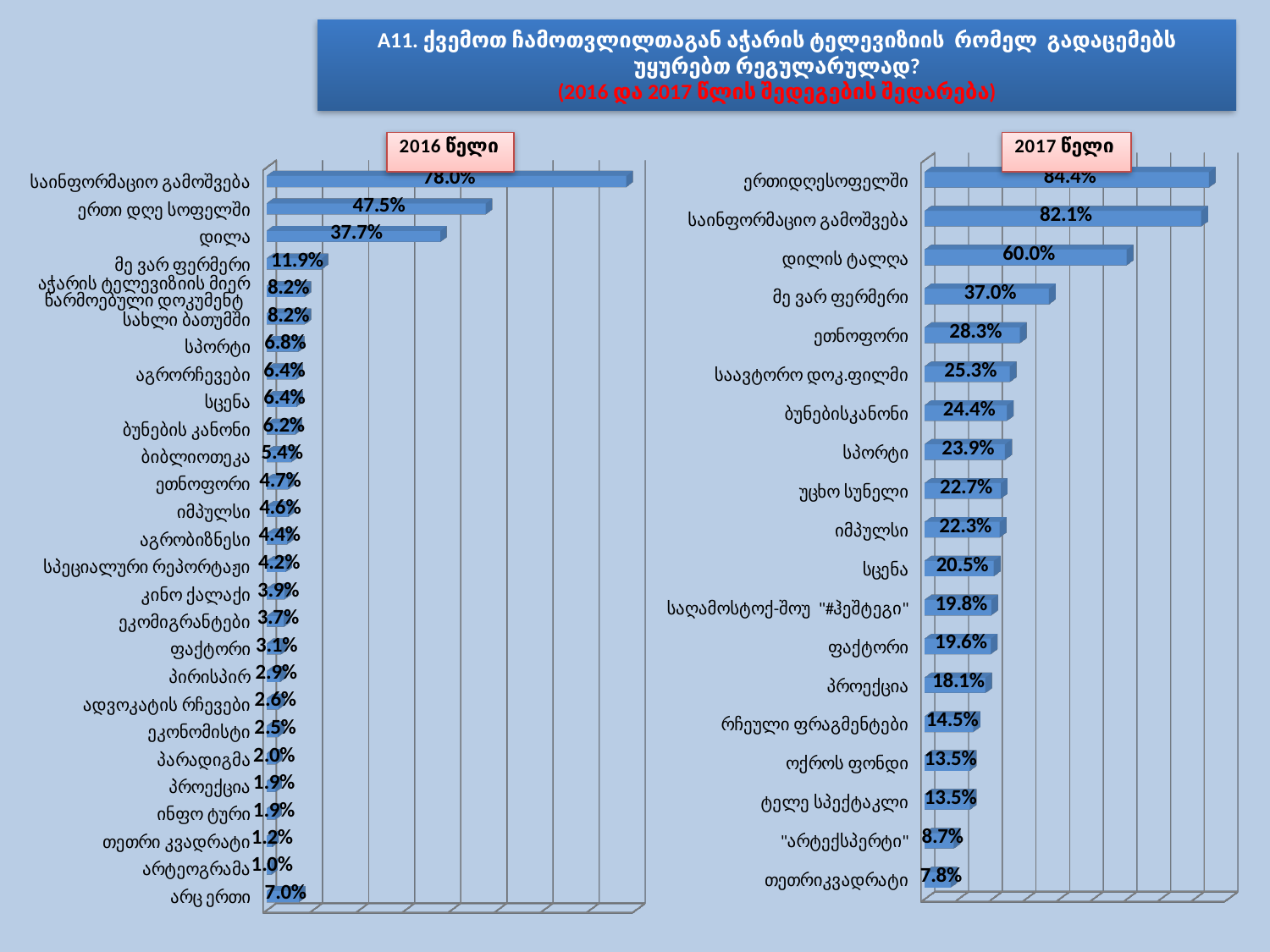
In the 2016 წელი chart (left), what is the difference between ერთი დღე სოფელში and დილა? 9.8% In the 2017 წელი chart (right), what is the difference between ერთიდღესოფელში and საინფორმაციო გამოშვება? 2.3% In the 2017 წელი chart (right), which is larger: მე ვარ ფერმერი or ეთნოფორი? მე ვარ ფერმერი In the 2016 წელი chart (left), what is the value for საინფორმაციო გამოშვება? 78.0% In the 2017 წელი chart (right), which category has the highest value? ერთიდღესოფელში What type of chart is the 2016 წელი chart (left)? Bar chart In the 2017 წელი chart (right), what is the value for დილის ტალღა? 60.0% In the 2017 წელი chart (right), which category has the lowest value? თეთრიკვადრატი In the 2016 წელი chart (left), what is the value for არც ერთი? 7.0% In the 2016 წელი chart (left), which is larger: სპორტი or ბიბლიოთეკა? სპორტი In the 2016 წელი chart (left), which category has the lowest value? არტეოგრამა How many categories are shown in the 2017 წელი chart (right)? 19